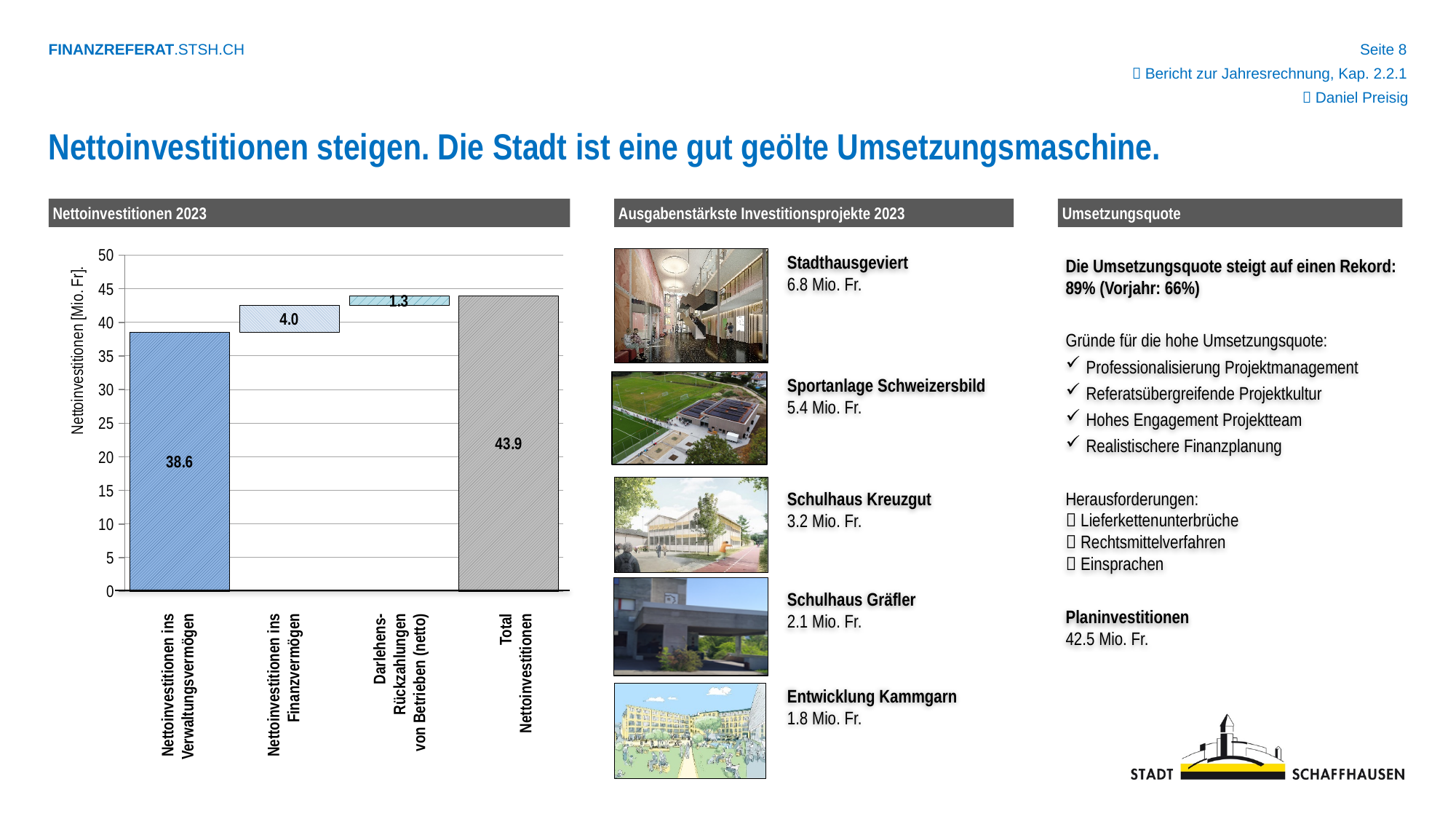
Which category has the lowest value in the Nettoinvestitionen 2023 chart? Darlehens-Rückzahlungen von Betrieben (netto) What is the value for Nettoinvestitionen ins Verwaltungsvermögen in the Nettoinvestitionen 2023 chart? 38.6 What is the value for Nettoinvestitionen ins Finanzvermögen in the Nettoinvestitionen 2023 chart? 4.0 Which category has the highest value in the Nettoinvestitionen 2023 chart? Total Nettoinvestitionen What is the difference between Nettoinvestitionen ins Verwaltungsvermögen and Nettoinvestitionen ins Finanzvermögen in the Nettoinvestitionen 2023 chart? 34.6 Which is larger in the Nettoinvestitionen 2023 chart: Nettoinvestitionen ins Finanzvermögen or Darlehens-Rückzahlungen von Betrieben (netto)? Nettoinvestitionen ins Finanzvermögen Is the value for Nettoinvestitionen ins Verwaltungsvermögen in the Nettoinvestitionen 2023 chart greater or less than 40? less What kind of chart is the Nettoinvestitionen 2023 chart? bar chart What is the y-axis label of the Nettoinvestitionen 2023 chart? Nettoinvestitionen [Mio. Fr.] What is the value for Darlehens-Rückzahlungen von Betrieben (netto) in the Nettoinvestitionen 2023 chart? 1.3 How many categories are shown on the x axis of the Nettoinvestitionen 2023 chart? 4 What is the value for Total Nettoinvestitionen in the Nettoinvestitionen 2023 chart? 43.9